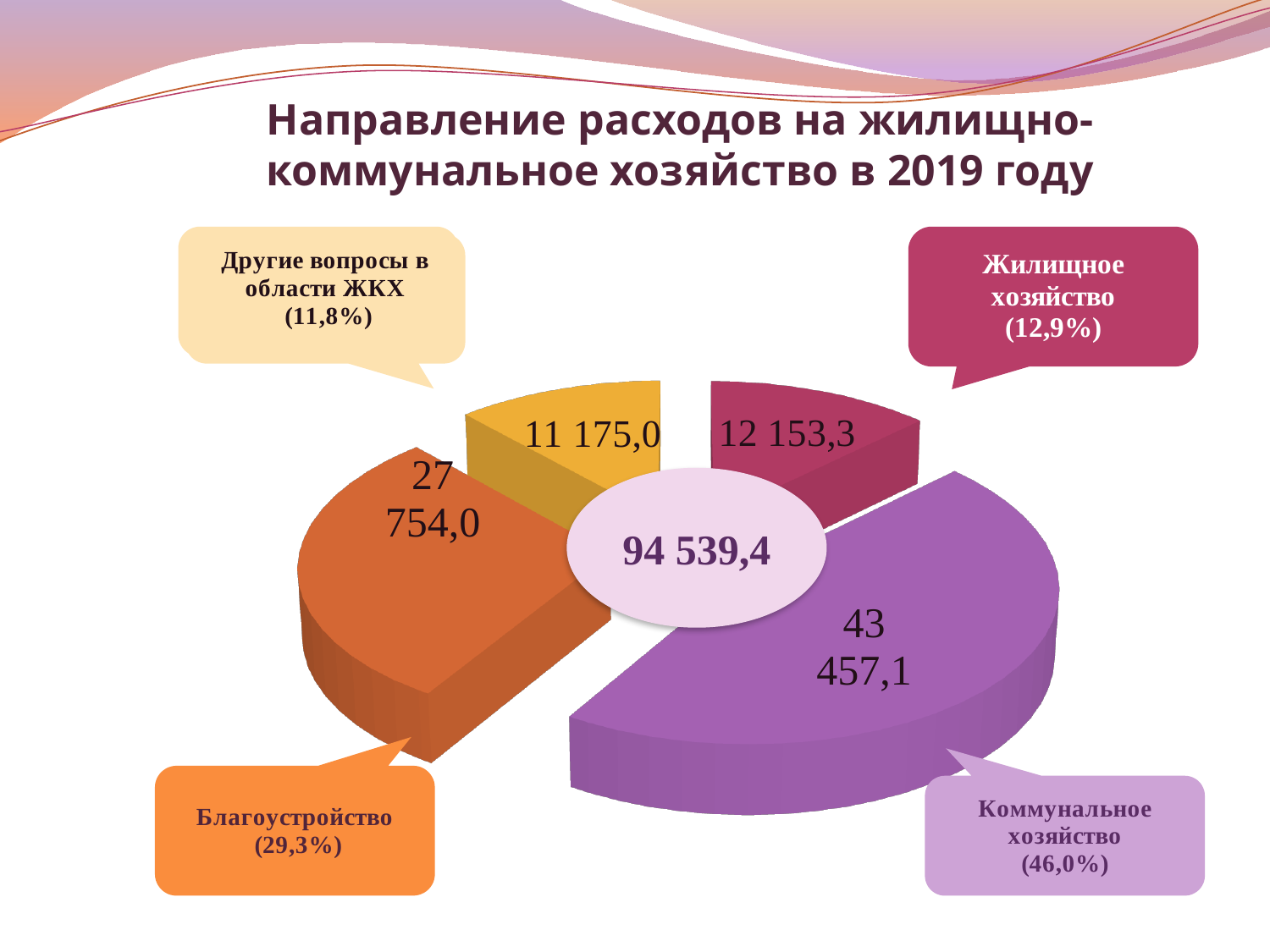
What is the difference between the values for Коммунальное хозяйство and Благоустройство? 15 703,1 What is the value for Коммунальное хозяйство? 43 457,1 What kind of chart is shown on the slide? pie chart What share of the pie does Коммунальное хозяйство represent? 46,0% How many slices does the pie chart have? 4 Which category has the largest slice of the pie? Коммунальное хозяйство What is the value for Другие вопросы в области ЖКХ? 11 175,0 Which category has the smallest slice of the pie? Другие вопросы в области ЖКХ What is the value for Благоустройство? 27 754,0 What is the value for Жилищное хозяйство? 12 153,3 Which is larger, the value for Жилищное хозяйство or the value for Другие вопросы в области ЖКХ? Жилищное хозяйство What share of the pie does Благоустройство represent? 29,3%